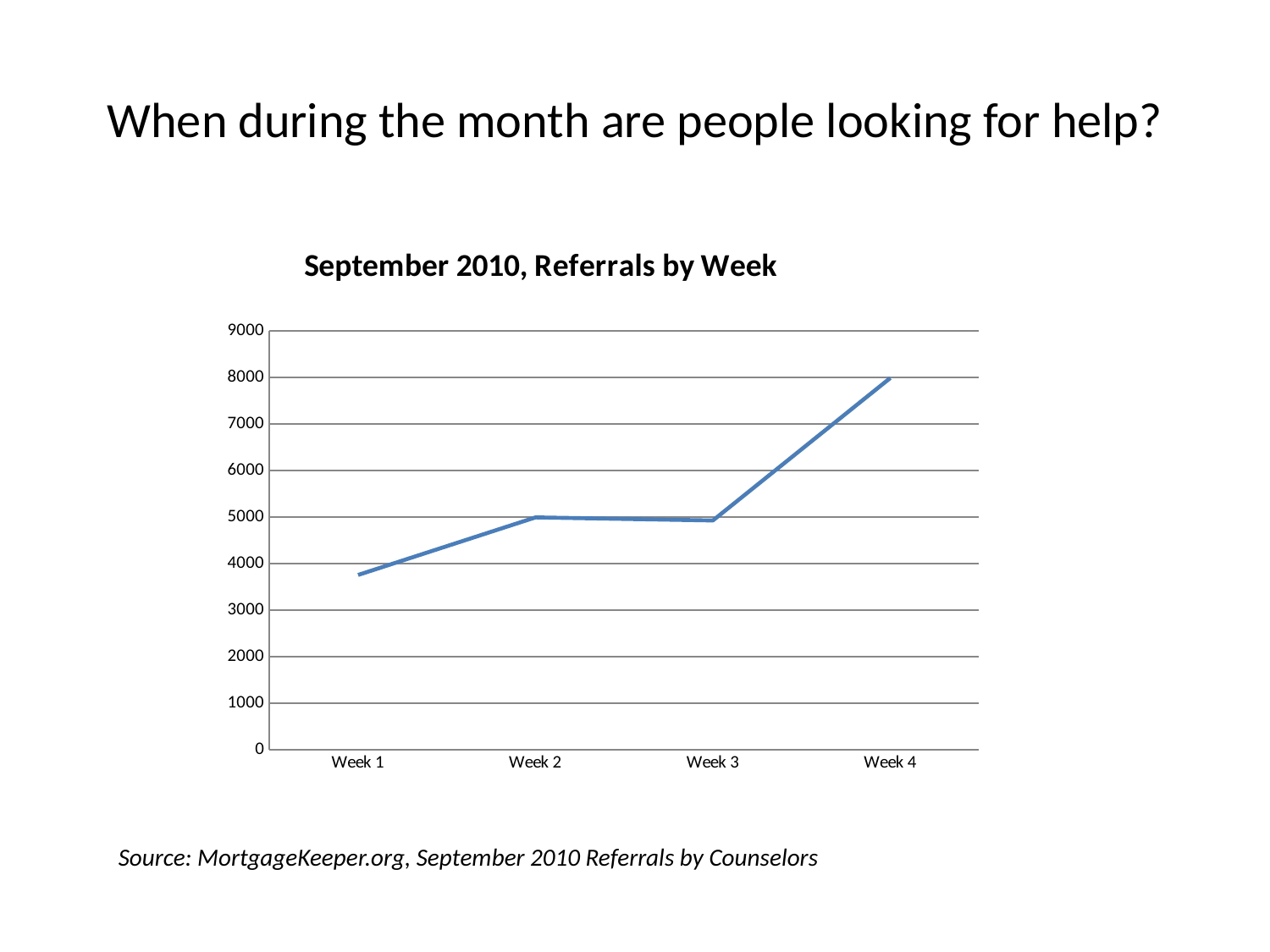
Is the value for Week 4 greater or less than 7000? greater Which week has the lowest number of referrals? Week 1 Is the value for Week 3 greater or less than 6000? less Do referrals rise or fall from Week 3 to Week 4? rise What kind of chart is shown on the slide? line chart Which has more referrals, Week 1 or Week 4? Week 4 Is the value for Week 1 greater or less than 4000? less Which week has the highest number of referrals? Week 4 How many weeks are plotted on the x axis of the chart? 4 What source is cited below the chart? MortgageKeeper.org, September 2010 Referrals by Counselors What is the title of the chart? September 2010, Referrals by Week